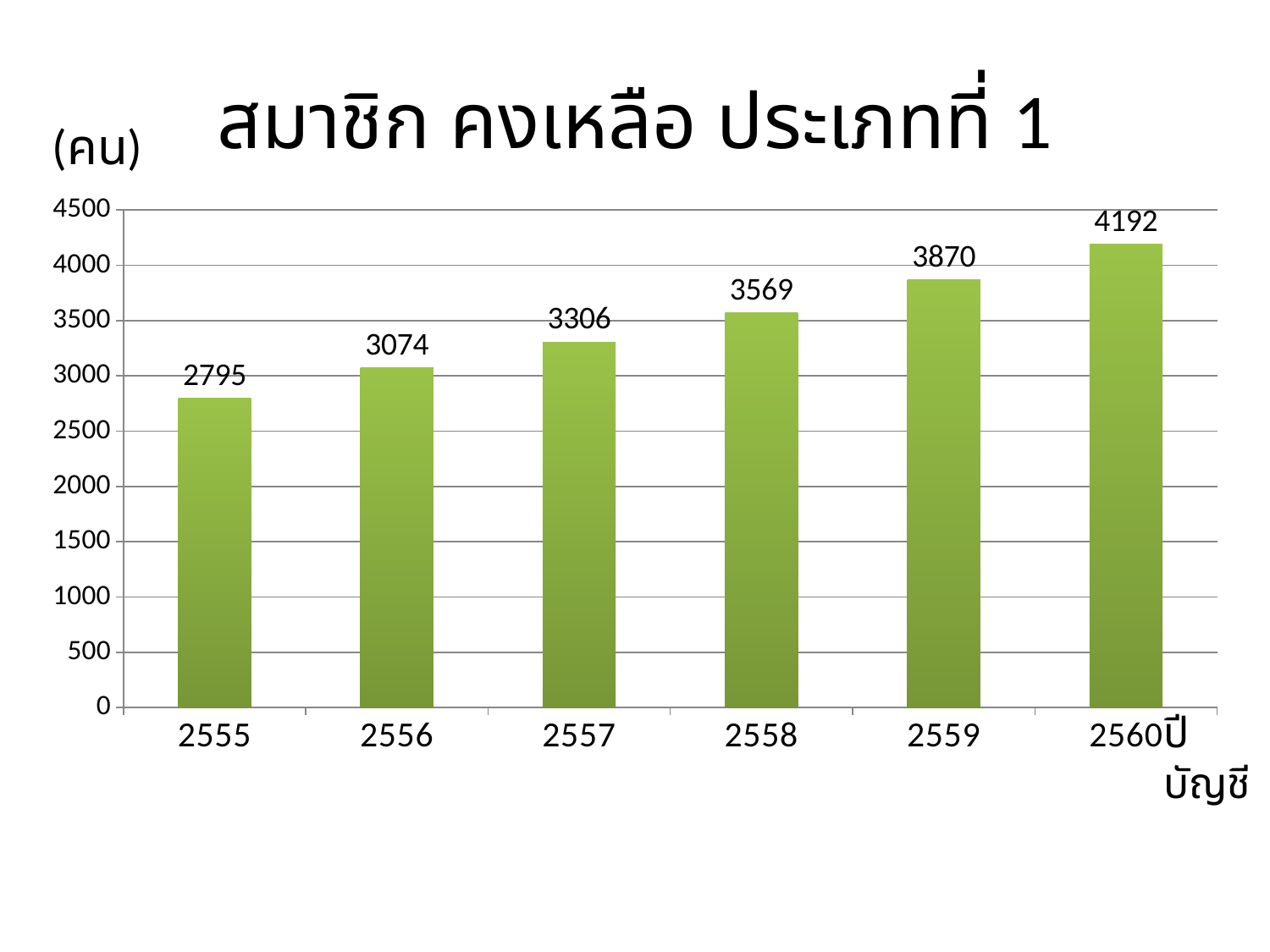
Which year has the lowest value? 2555 Which year has the highest value? 2560 What is the value for 2558? 3569 Do the values rise or fall from 2555 to 2560? rise Is the value for 2559 greater or less than 3500? greater How many years are shown on the x axis? 6 Which is larger, the value for 2558 or the value for 2557? 2558 What is the value for 2555? 2795 What is the value for 2560? 4192 What is the difference between the values for 2560 and 2559? 322 What is the difference between the values for 2557 and 2556? 232 What kind of chart is this? bar chart